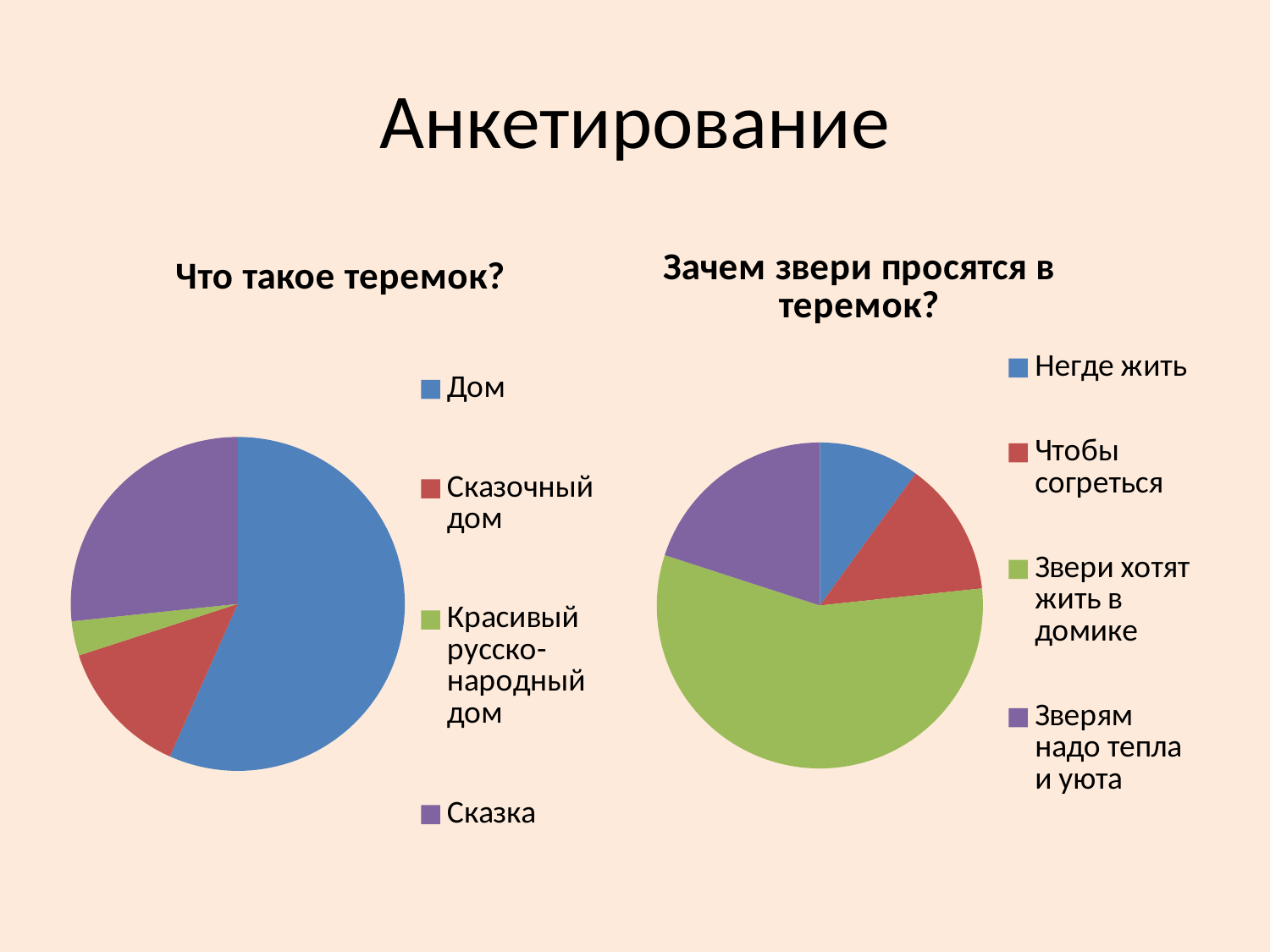
In the chart "Зачем звери просятся в теремок?", which slice is larger: "Звери хотят жить в домике" or "Чтобы согреться"? Звери хотят жить в домике In the chart "Что такое теремок?", which slice is larger: "Сказка" or "Сказочный дом"? Сказка In the chart "Зачем звери просятся в теремок?", what colour is the slice for "Негде жить"? blue What kind of chart is the chart titled "Что такое теремок?"? pie chart In the chart "Зачем звери просятся в теремок?", which slice is larger: "Зверям надо тепла и уюта" or "Негде жить"? Зверям надо тепла и уюта In the chart "Что такое теремок?", which category has the smallest slice? Красивый русско-народный дом In the chart "Зачем звери просятся в теремок?", how many categories does the legend list? 4 What kind of chart is the chart titled "Зачем звери просятся в теремок?"? pie chart In the chart "Что такое теремок?", which category has the largest slice? Дом In the chart "Что такое теремок?", how many slices does the pie have? 4 In the chart "Зачем звери просятся в теремок?", which category has the largest slice? Звери хотят жить в домике What is the title of the left chart on the slide? Что такое теремок?